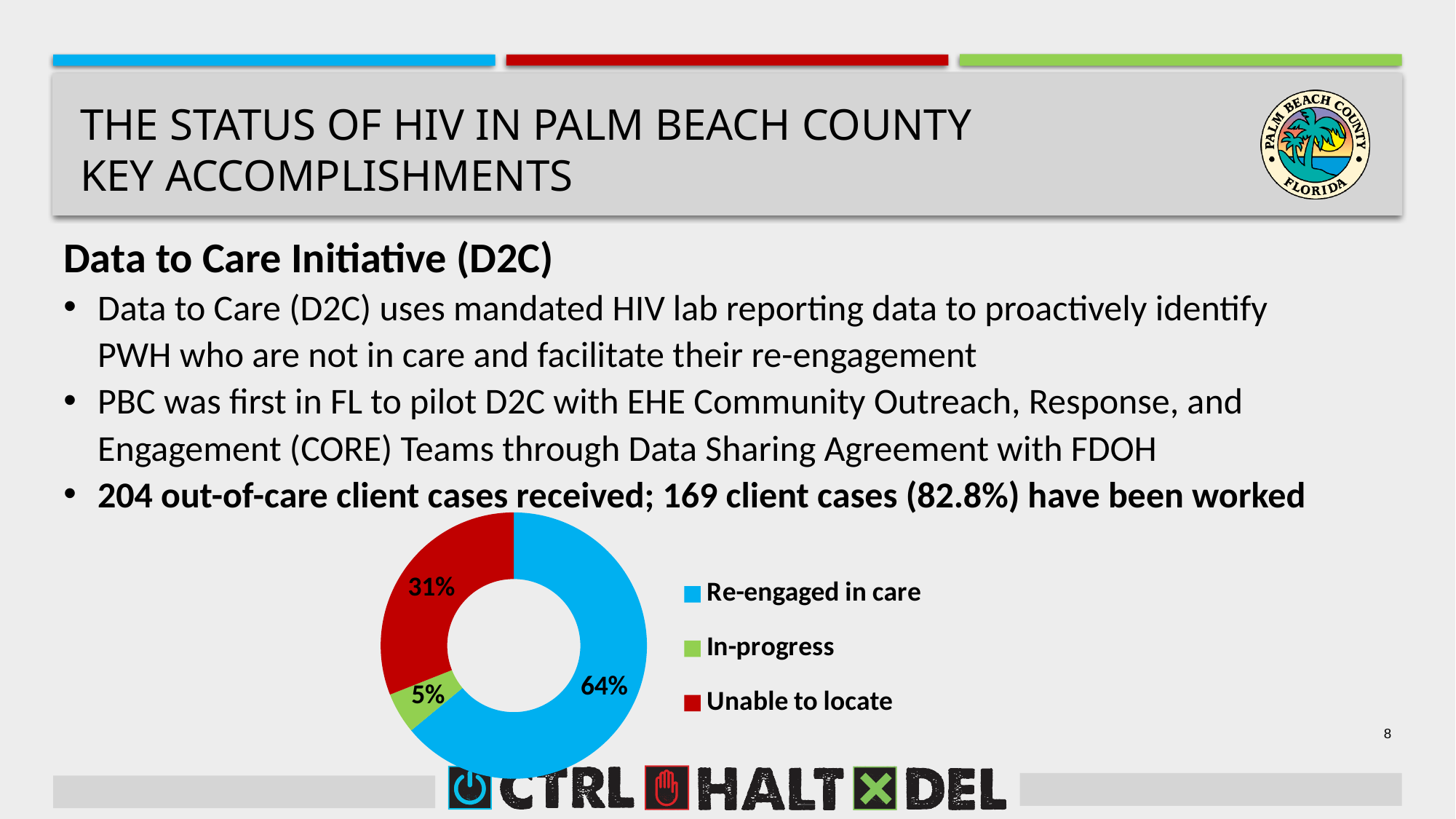
What colour represents In-progress in the chart? Green What percentage of the donut chart is labelled Unable to locate? 31% What is the combined share of Re-engaged in care and In-progress? 69% What kind of chart is shown on the slide? Donut (pie) chart What colour represents Unable to locate in the chart? Red Which category has the smallest share of the donut chart? In-progress Which is larger in the donut chart, Unable to locate or In-progress? Unable to locate What is the difference in percentage points between Re-engaged in care and Unable to locate? 33 What percentage of the donut chart is labelled Re-engaged in care? 64% What percentage of the donut chart is labelled In-progress? 5% How many categories does the donut chart show? 3 Which category has the largest share of the donut chart? Re-engaged in care